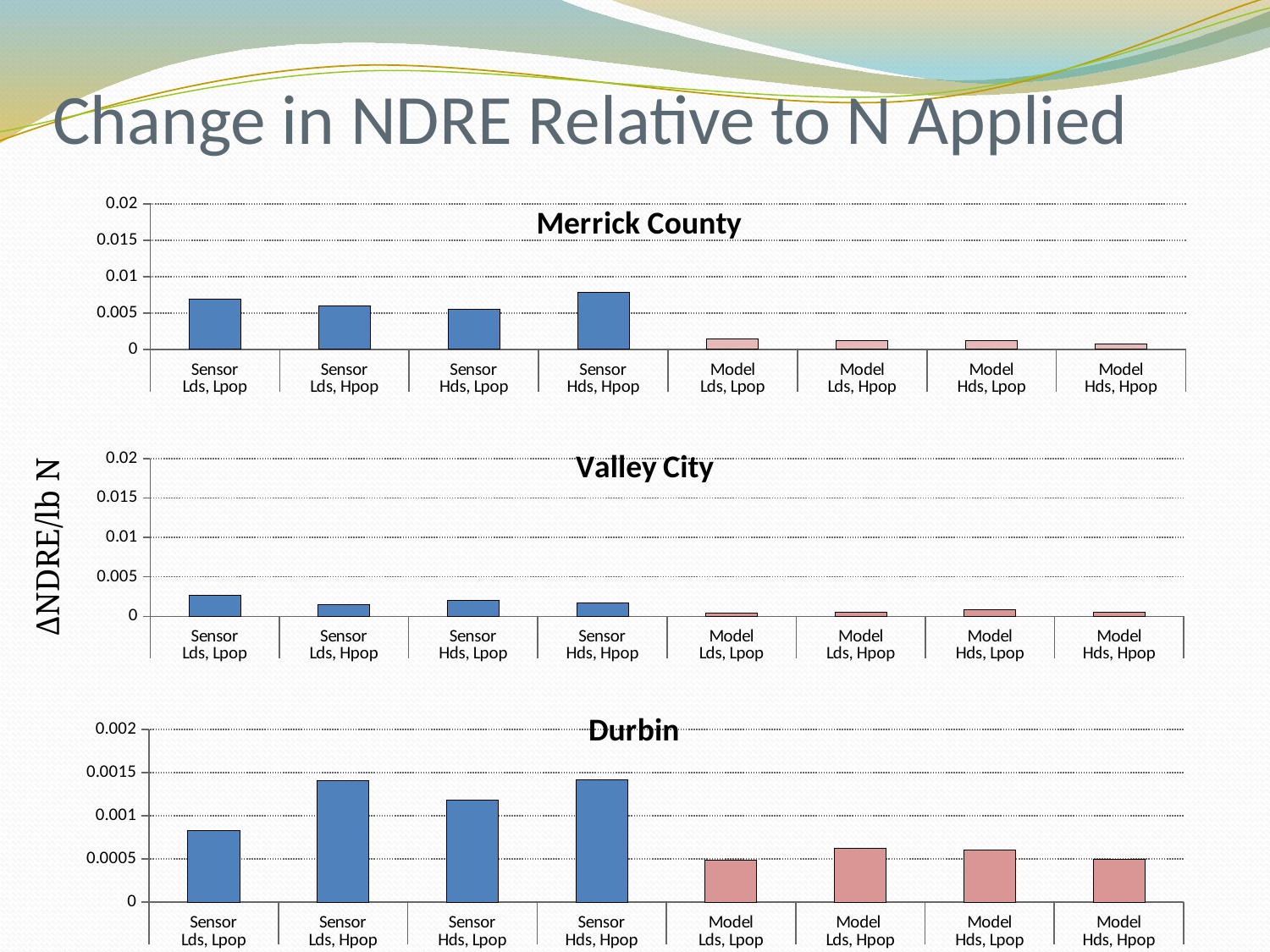
How many categories are shown on the x axis of the Durbin chart? 8 What kind of chart is the Merrick County chart? bar chart In the Merrick County chart, which category has the lowest value? Model Hds, Hpop In the Durbin chart, which is larger, the value for Sensor Lds, Hpop or the value for Sensor Lds, Lpop? Sensor Lds, Hpop In the Merrick County chart, is the value for Sensor Lds, Lpop greater or less than 0.005? greater What is the label on the shared y axis of the charts? ΔNDRE/lb N In the Merrick County chart, is the value for Model Lds, Lpop greater or less than 0.005? less In the Durbin chart, which is larger, the value for Sensor Lds, Lpop or the value for Model Lds, Lpop? Sensor Lds, Lpop In the Valley City chart, is the value for Sensor Lds, Lpop greater or less than 0.005? less In the Merrick County chart, which category has the highest value? Sensor Hds, Hpop In the Valley City chart, which category has the highest value? Sensor Lds, Lpop